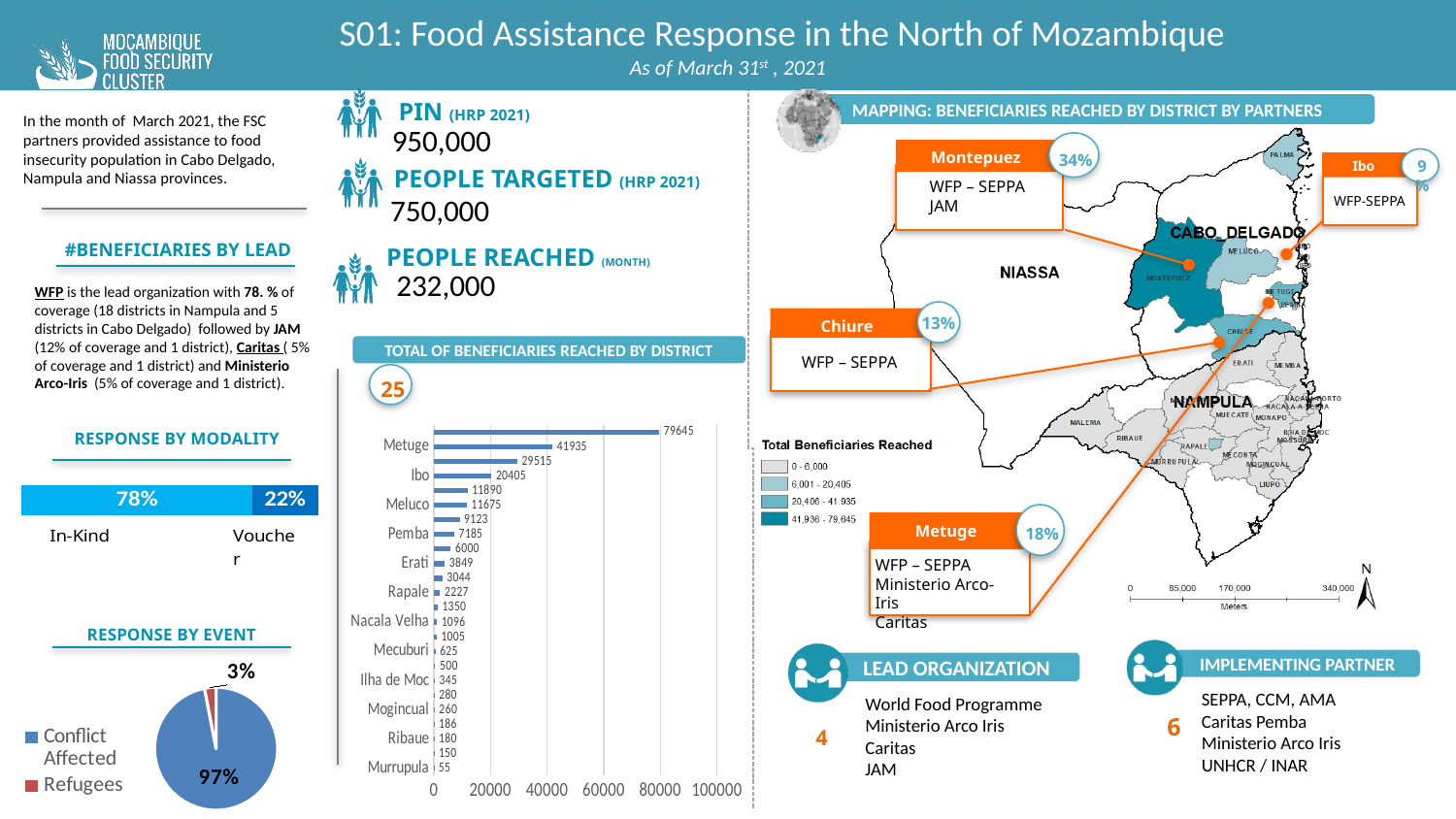
How many slices does the 'RESPONSE BY EVENT' pie chart have? 2 In the 'RESPONSE BY EVENT' pie chart, what share is Refugees? 3% In the 'RESPONSE BY EVENT' pie chart, what share is Conflict Affected? 97% In the 'TOTAL OF BENEFICIARIES REACHED BY DISTRICT' chart, what is the value for Pemba? 7185 In the 'TOTAL OF BENEFICIARIES REACHED BY DISTRICT' chart, what is the value for Metuge? 41935 What kind of chart is the 'TOTAL OF BENEFICIARIES REACHED BY DISTRICT' chart? bar chart In the 'TOTAL OF BENEFICIARIES REACHED BY DISTRICT' chart, which is larger, the value for Meluco or the value for Erati? Meluco In the 'TOTAL OF BENEFICIARIES REACHED BY DISTRICT' chart, what is the value for Murrupula? 55 In the 'TOTAL OF BENEFICIARIES REACHED BY DISTRICT' chart, what is the value for Ibo? 20405 In the 'TOTAL OF BENEFICIARIES REACHED BY DISTRICT' chart, is the value for Ibo greater or less than 40000? less In the 'TOTAL OF BENEFICIARIES REACHED BY DISTRICT' chart, what is the difference between the values for Metuge and Ibo? 21530 In the 'TOTAL OF BENEFICIARIES REACHED BY DISTRICT' chart, which labelled district has the lowest value? Murrupula